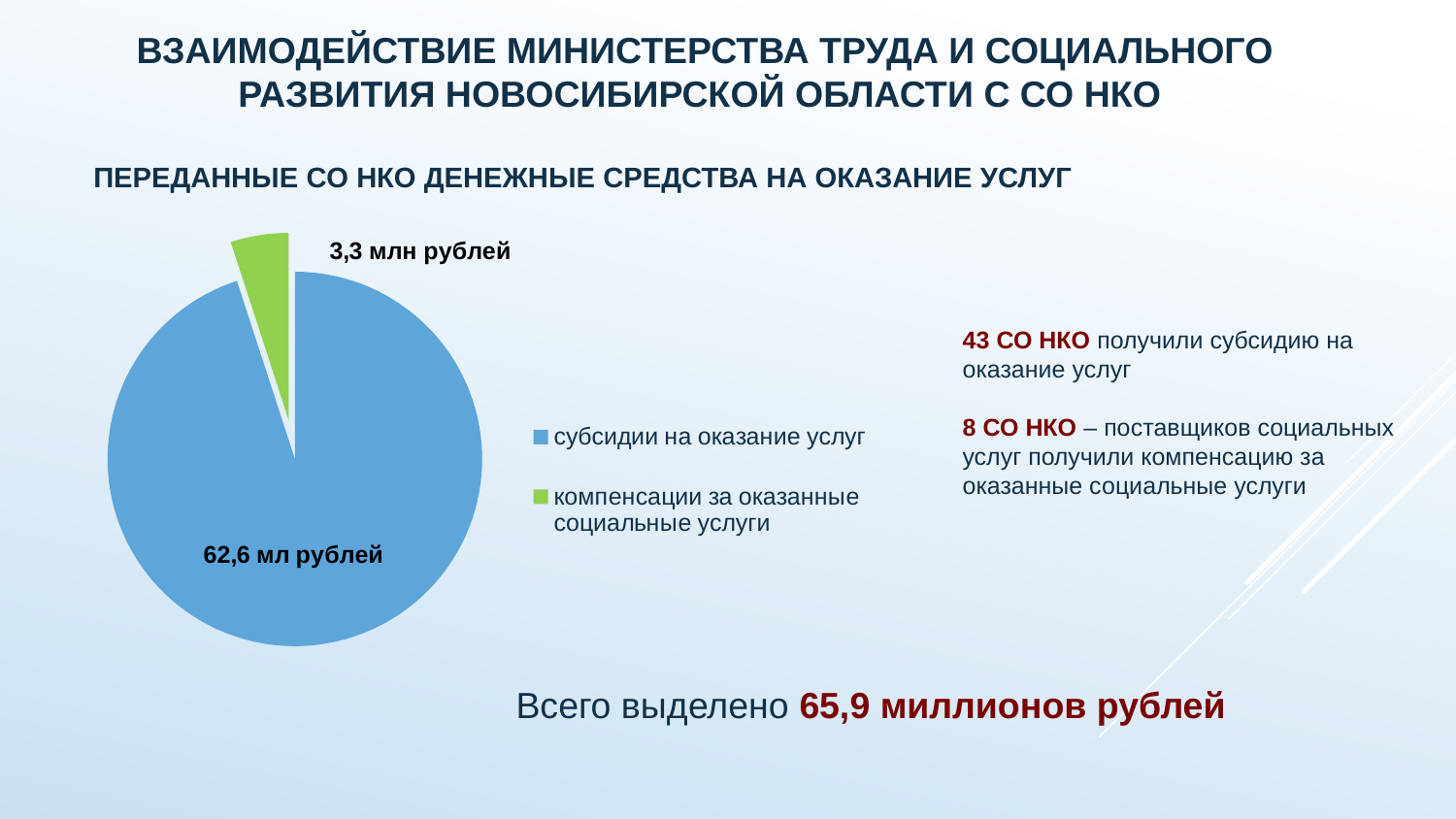
Which is larger: the value for "субсидии на оказание услуг" or the value for "компенсации за оказанные социальные услуги"? субсидии на оказание услуг What is the total of the two slices in the pie chart? 65,9 млн рублей What type of chart is shown on the slide? Pie chart How many slices does the pie chart have? 2 How many entries does the legend of the pie chart list? 2 What value is shown for the slice "субсидии на оказание услуг"? 62,6 мл рублей What is the difference between the value for "субсидии на оказание услуг" and the value for "компенсации за оказанные социальные услуги"? 59,3 млн рублей What value is shown for the slice "компенсации за оказанные социальные услуги"? 3,3 млн рублей Which slice of the pie chart is the smallest? компенсации за оказанные социальные услуги What share of the pie does the slice "компенсации за оказанные социальные услуги" represent? 5% Which slice of the pie chart is the largest? субсидии на оказание услуг What colour is the slice for "субсидии на оказание услуг"? Blue